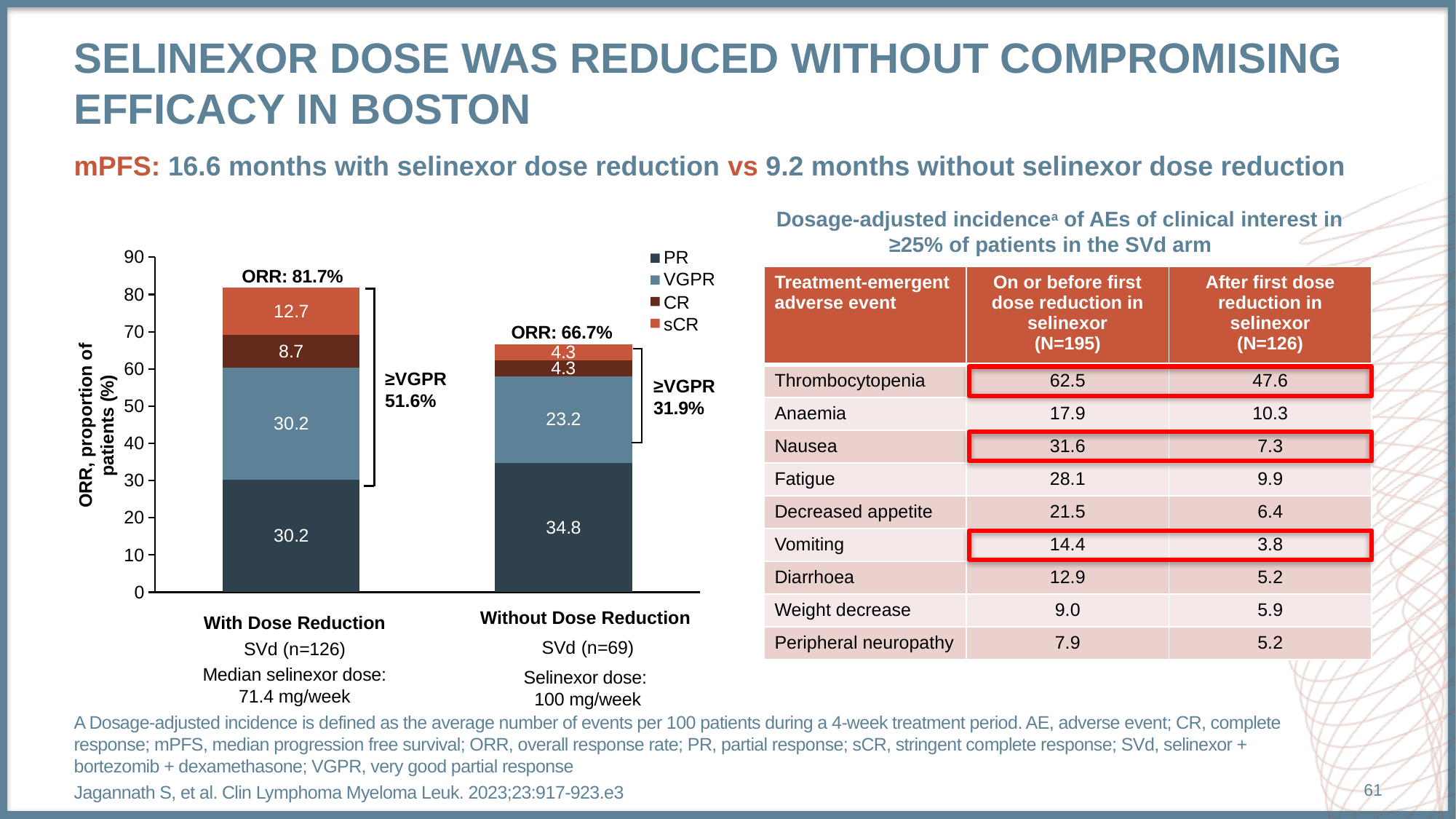
What is the label of the y axis of the chart? ORR, proportion of patients (%) What is the CR value for the Without Dose Reduction bar? 4.3 What is the difference between the sCR values for With Dose Reduction and Without Dose Reduction? 8.4 How many series does the chart legend list? 4 Which bar has the larger PR segment, With Dose Reduction or Without Dose Reduction? Without Dose Reduction What is the sCR value for the With Dose Reduction bar? 12.7 What is the PR value for the With Dose Reduction bar? 30.2 What type of chart is shown on the slide? Stacked bar chart What is the VGPR value for the Without Dose Reduction bar? 23.2 How many categories are plotted on the x axis of the chart? 2 Is the total height of the Without Dose Reduction bar greater or less than 70? less What is the ORR shown above the With Dose Reduction bar? 81.7%